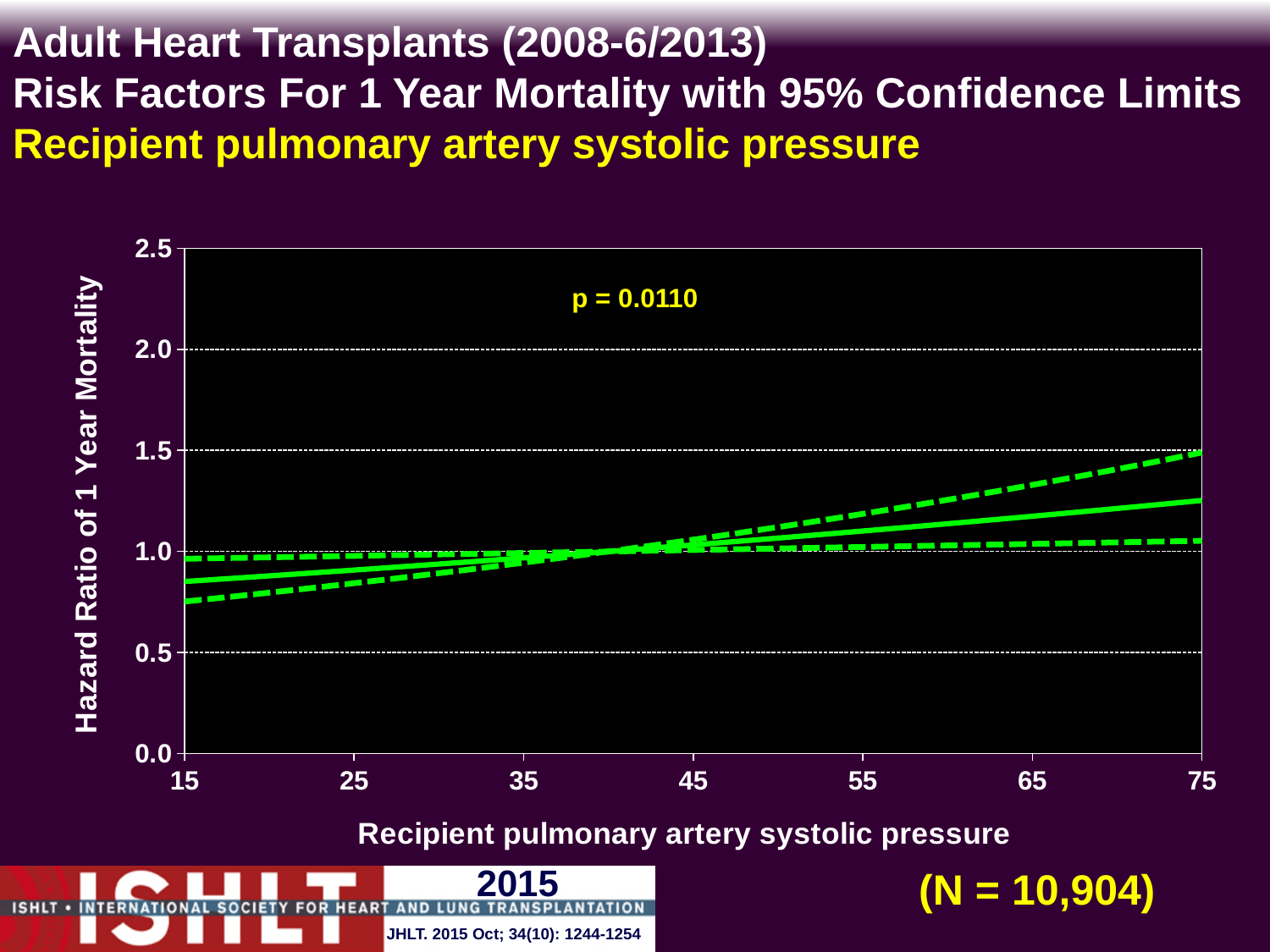
Is the lower 95% confidence limit at a recipient pulmonary artery systolic pressure of 15 greater or less than 1.0? less Does the hazard ratio of 1 year mortality rise or fall as recipient pulmonary artery systolic pressure increases from 15 to 75? Rise Is the hazard ratio (solid line) at a recipient pulmonary artery systolic pressure of 75 larger or smaller than at 15? larger How many lines are plotted on the chart? 3 Is the upper 95% confidence limit at a recipient pulmonary artery systolic pressure of 75 greater or less than 1.0? greater Is the lower 95% confidence limit at a recipient pulmonary artery systolic pressure of 75 greater or less than 1.5? less What kind of chart is shown on the slide? Line chart What p-value is shown on the chart? p = 0.0110 What is the sample size (N) shown on the slide? N = 10,904